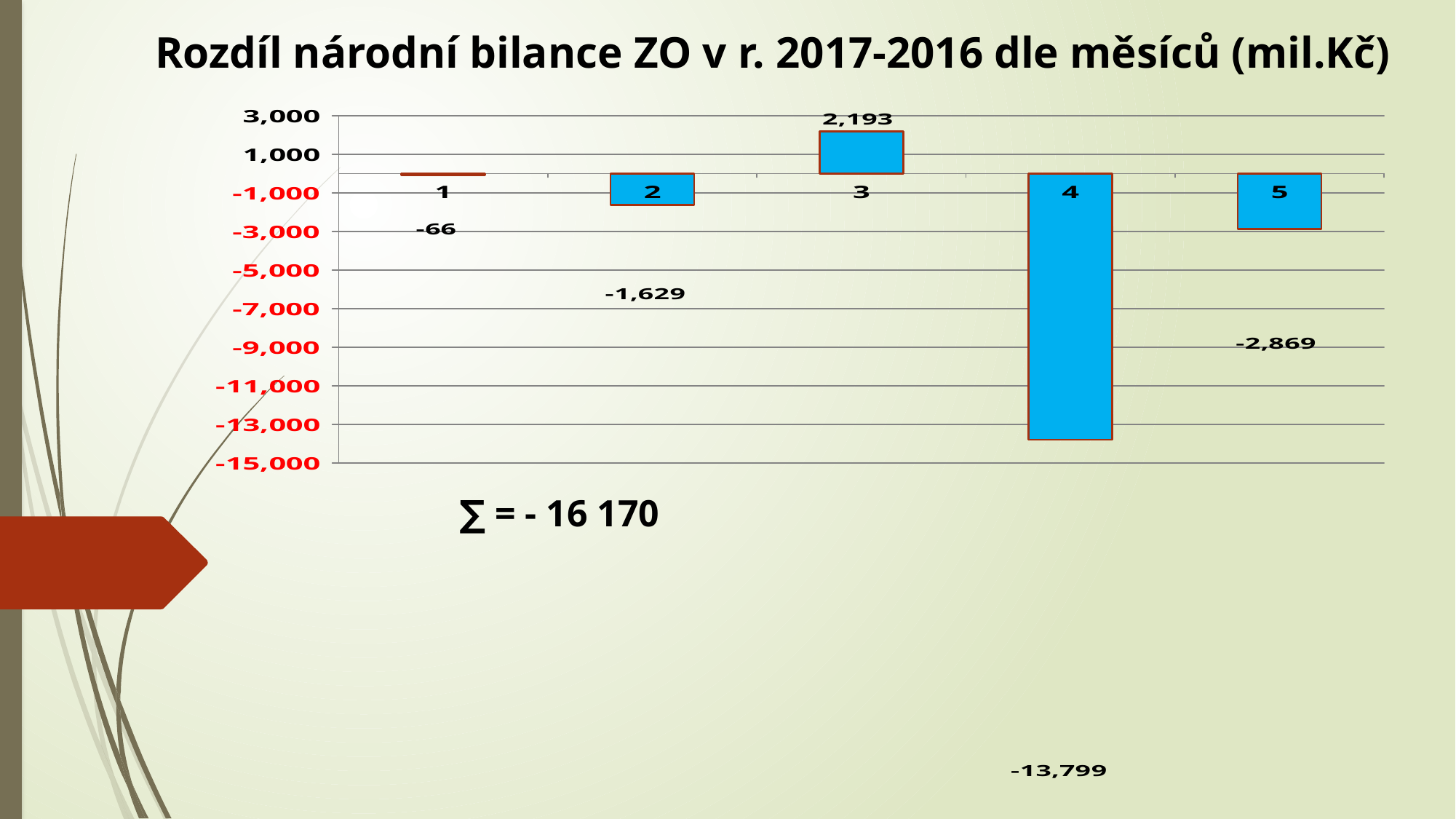
Which month has the lowest value? 4 Which is larger, the value for month 1 or the value for month 2? month 1 What is the value for month 4? -13,799 What is the value for month 1? -66 What kind of chart is shown on the slide? bar chart Which month has the highest value? 3 What is the difference between the values for month 2 and month 5? 1,240 What is the value for month 3? 2,193 Is the value for month 4 greater or less than -11,000? less How many months are shown on the x axis? 5 What is the value for month 5? -2,869 What total (∑) is printed below the chart? - 16 170